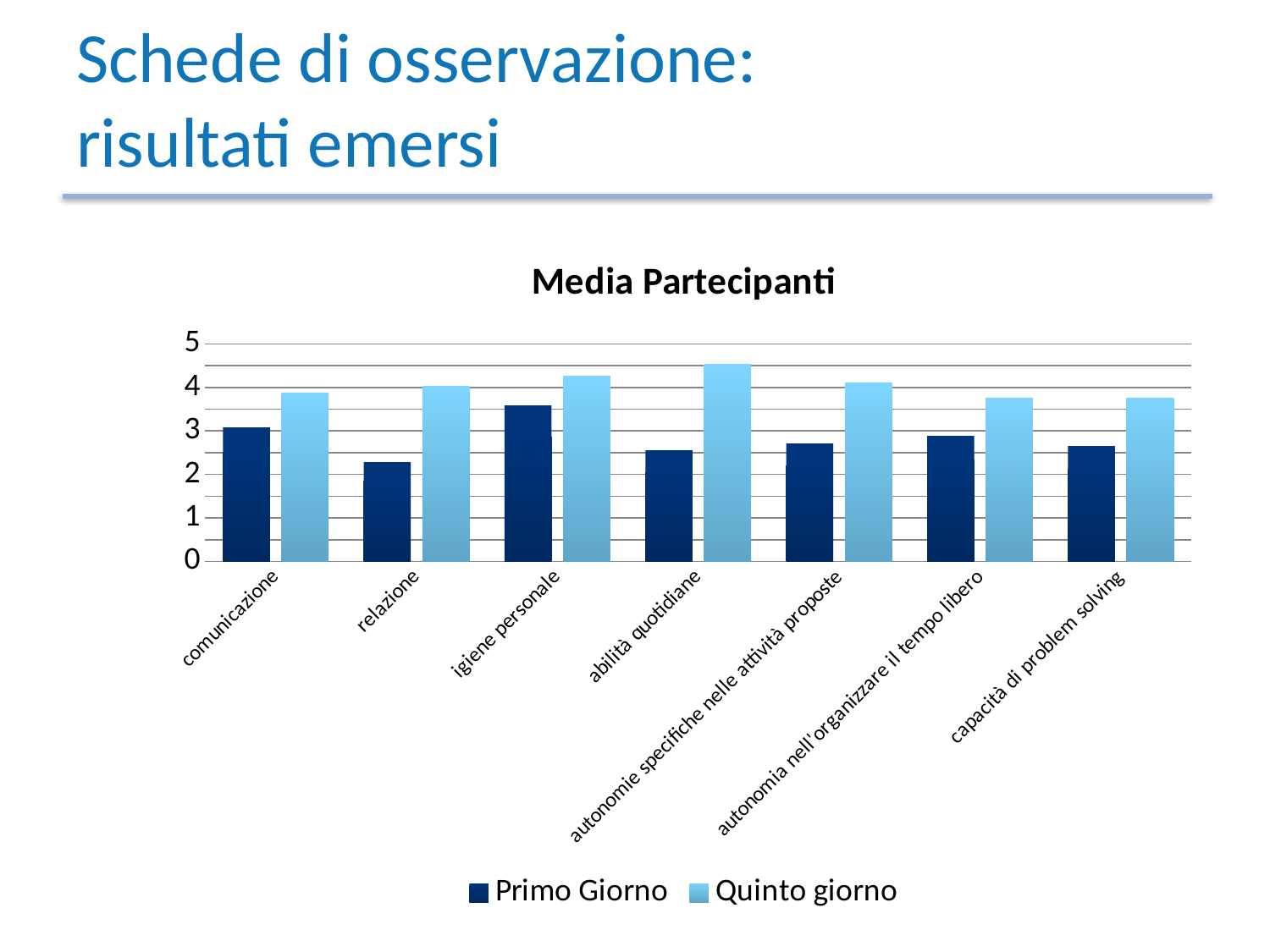
Which category has the highest Primo Giorno value? igiene personale Which category has the highest Quinto giorno value? abilità quotidiane Is the Primo Giorno value for igiene personale greater or less than 3? greater Which category has the lowest Primo Giorno value? relazione Is the Quinto giorno value for abilità quotidiane greater or less than 4? greater How many categories are shown on the x axis? 7 How many series does the legend list? 2 For comunicazione, which is larger: the Primo Giorno value or the Quinto giorno value? Quinto giorno What is the title of the chart? Media Partecipanti Is the Primo Giorno value for relazione greater or less than 3? less What kind of chart is shown on the slide? bar chart Which series is shown in dark blue in the legend? Primo Giorno